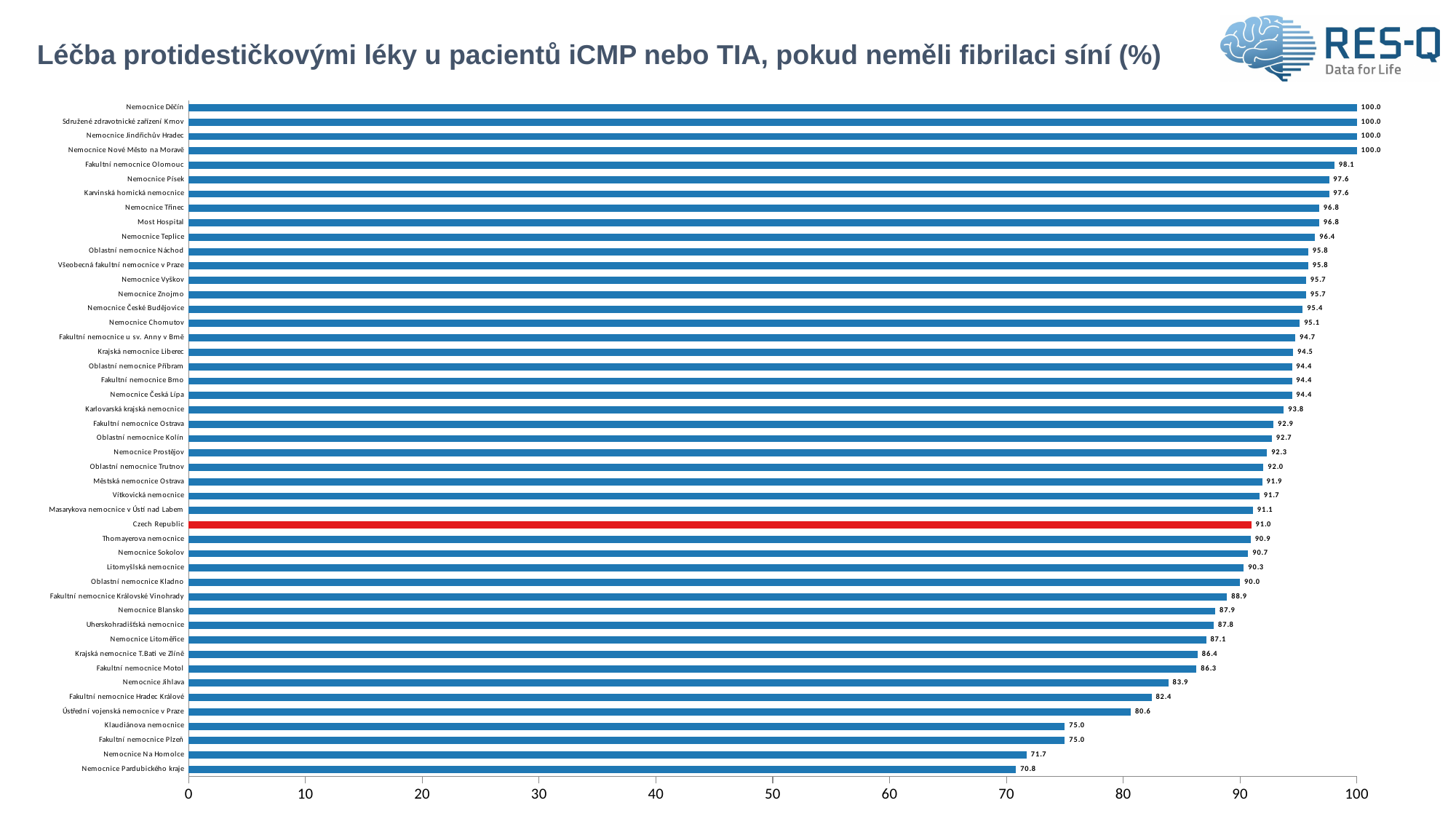
Which is larger, the value for Nemocnice Blansko or the value for Nemocnice Litoměřice? Nemocnice Blansko Which hospital has the lowest value? Nemocnice Pardubického kraje Is the value for Ústřední vojenská nemocnice v Praze greater or less than 90? less What is the difference between the values for Czech Republic and Fakultní nemocnice Hradec Králové? 8.6 What kind of chart is shown on the slide? bar chart What is the value for Czech Republic? 91.0 What is the difference between the values for Nemocnice Na Homolce and Nemocnice Pardubického kraje? 0.9 What is the value for Fakultní nemocnice Olomouc? 98.1 Which bar is highlighted in red? Czech Republic What is the value for Fakultní nemocnice Motol? 86.3 What is the value for Nemocnice Jihlava? 83.9 How many bars are shown in the chart? 47